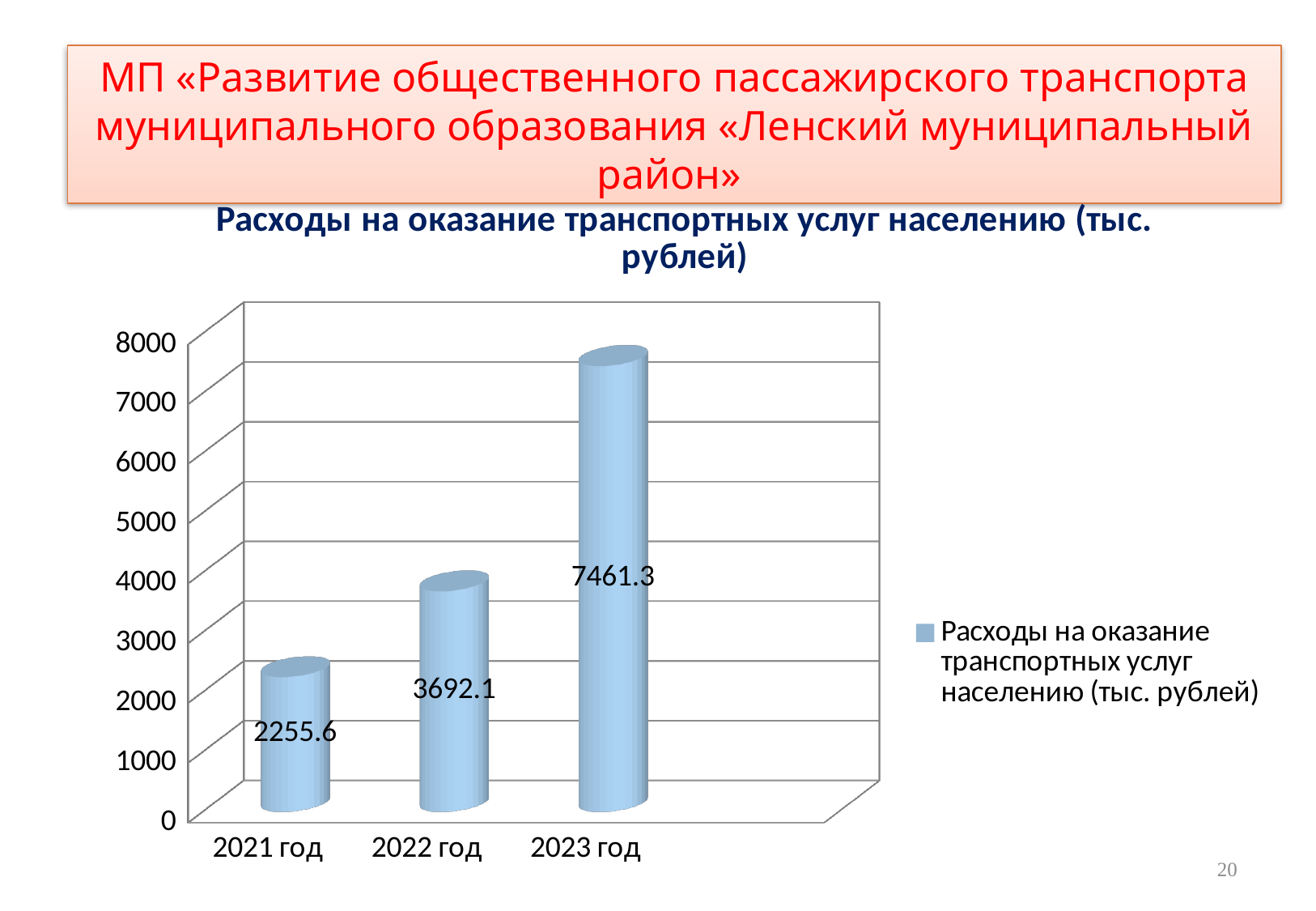
What kind of chart is shown? bar chart Do the values rise or fall from 2021 год to 2023 год? rise What is the value for 2022 год? 3692.1 Which year has the lowest expenditure? 2021 год How many series does the legend list? 1 How many years are shown on the chart? 3 What is the difference between the values for 2022 год and 2021 год? 1436.5 Which year has the highest expenditure? 2023 год What is the value for 2023 год? 7461.3 What is the difference between the values for 2023 год and 2022 год? 3769.2 Which is larger, the value for 2021 год or the value for 2022 год? 2022 год What is the value for 2021 год? 2255.6